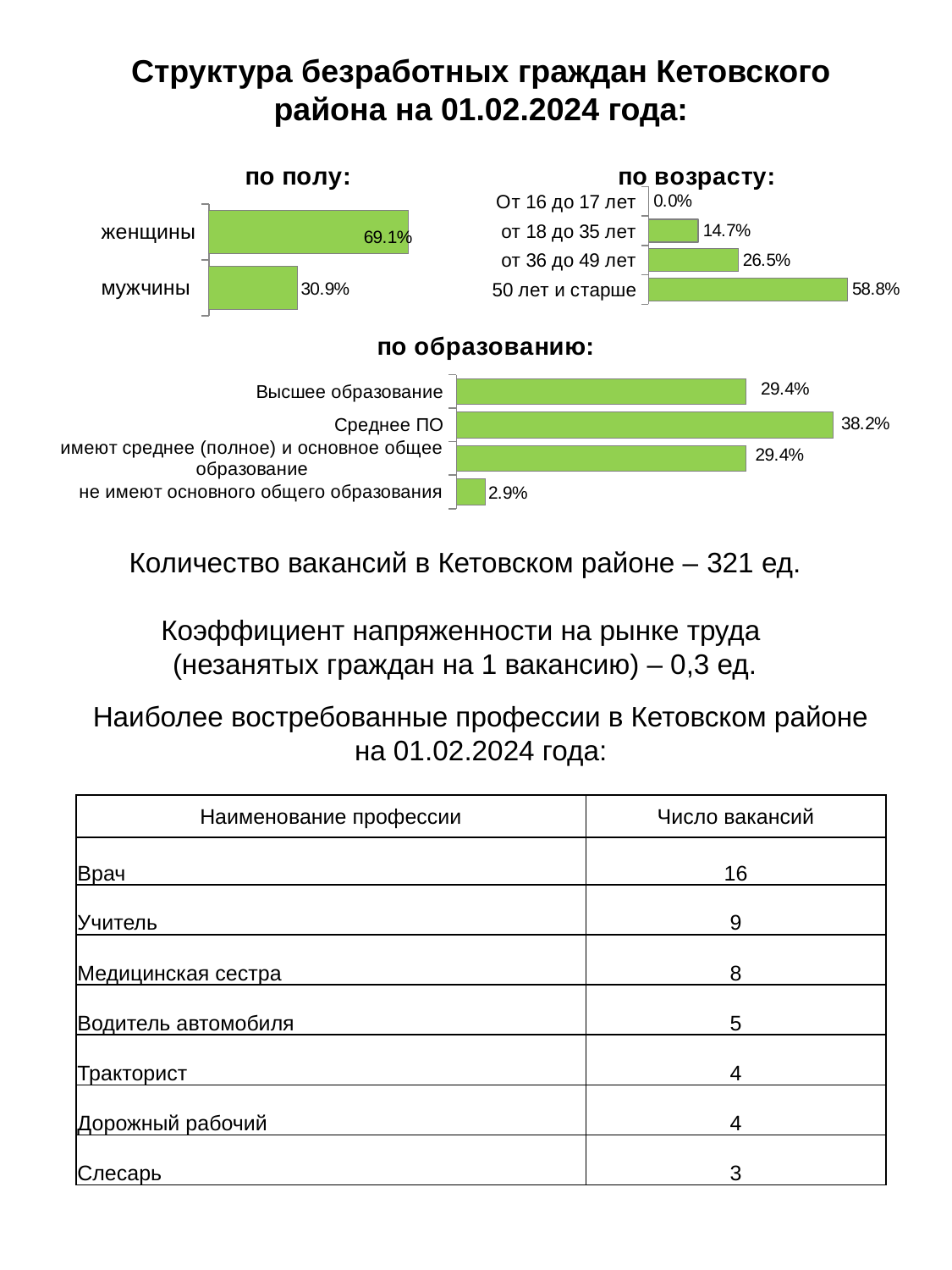
In the "по возрасту:" chart, which age group has the lowest value? От 16 до 17 лет What kind of chart is the "по образованию:" chart? bar chart In the "по возрасту:" chart, how many age categories are shown? 4 In the "по полу:" chart, what is the difference between the values for женщины and мужчины? 38.2% In the "по образованию:" chart, how many categories are shown? 4 In the "по образованию:" chart, what is the value for Среднее ПО? 38.2% In the "по образованию:" chart, which is larger: Среднее ПО or Высшее образование? Среднее ПО In the "по образованию:" chart, which category has the lowest value? не имеют основного общего образования In the "по возрасту:" chart, what is the value for от 36 до 49 лет? 26.5% In the "по возрасту:" chart, which age group has the highest value? 50 лет и старше In the "по полу:" chart, what is the value for женщины? 69.1% In the "по возрасту:" chart, what is the difference between the values for 50 лет и старше and от 18 до 35 лет? 44.1%